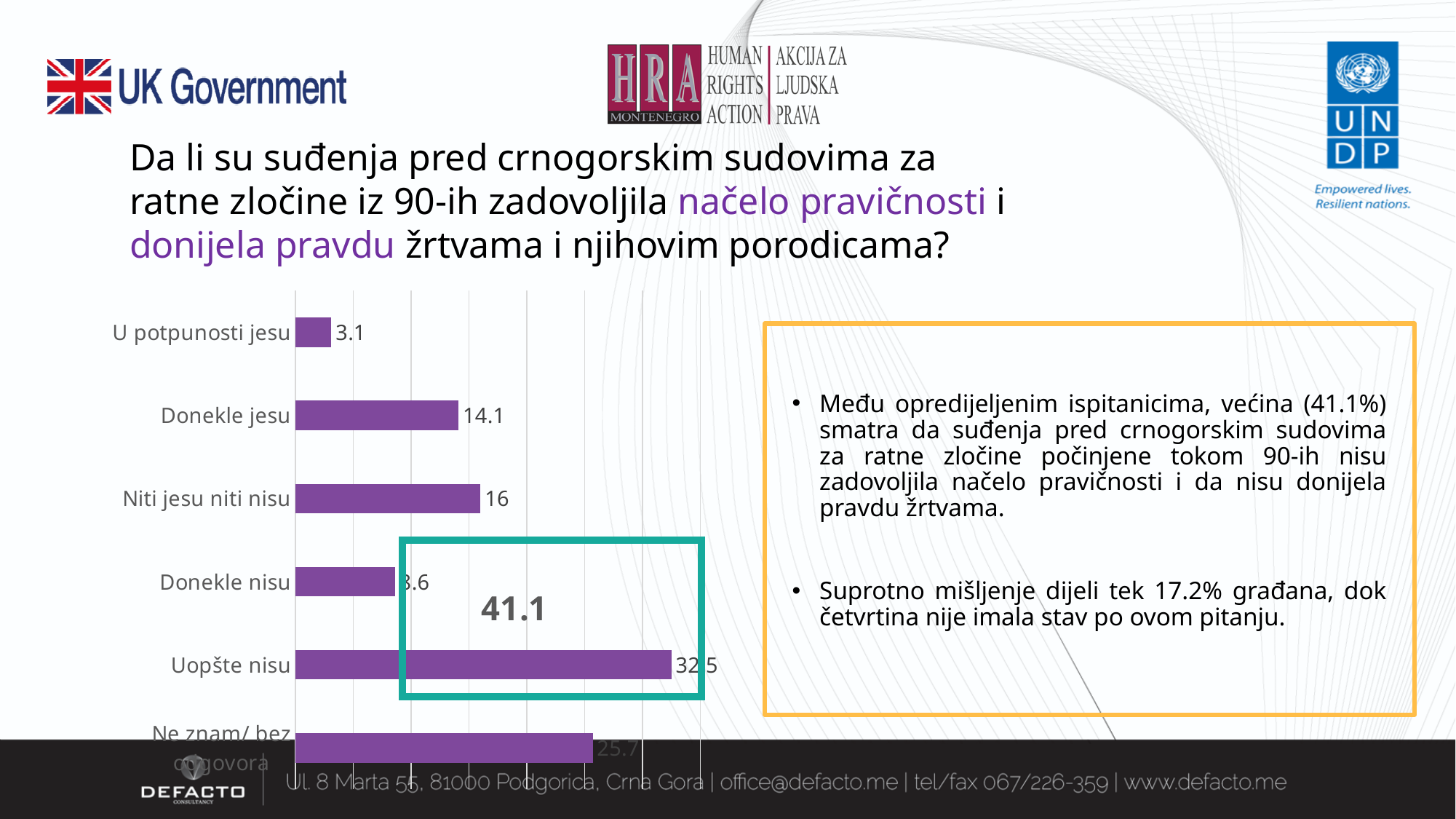
What number is printed inside the teal highlight box on the chart? 41.1 How many categories does the bar chart show? 6 What kind of chart is shown on the slide? bar chart What is the value for "U potpunosti jesu"? 3.1 Which category has the lowest value? U potpunosti jesu What is the difference between the values for "Niti jesu niti nisu" and "Donekle jesu"? 1.9 Which is larger, the value for "Donekle jesu" or the value for "Niti jesu niti nisu"? Niti jesu niti nisu Which category has the highest value? Uopšte nisu What is the value for "Ne znam/ bez odgovora"? 25.7 What is the value for "Donekle jesu"? 14.1 What is the value for "Niti jesu niti nisu"? 16 What is the value for "Uopšte nisu"? 32.5